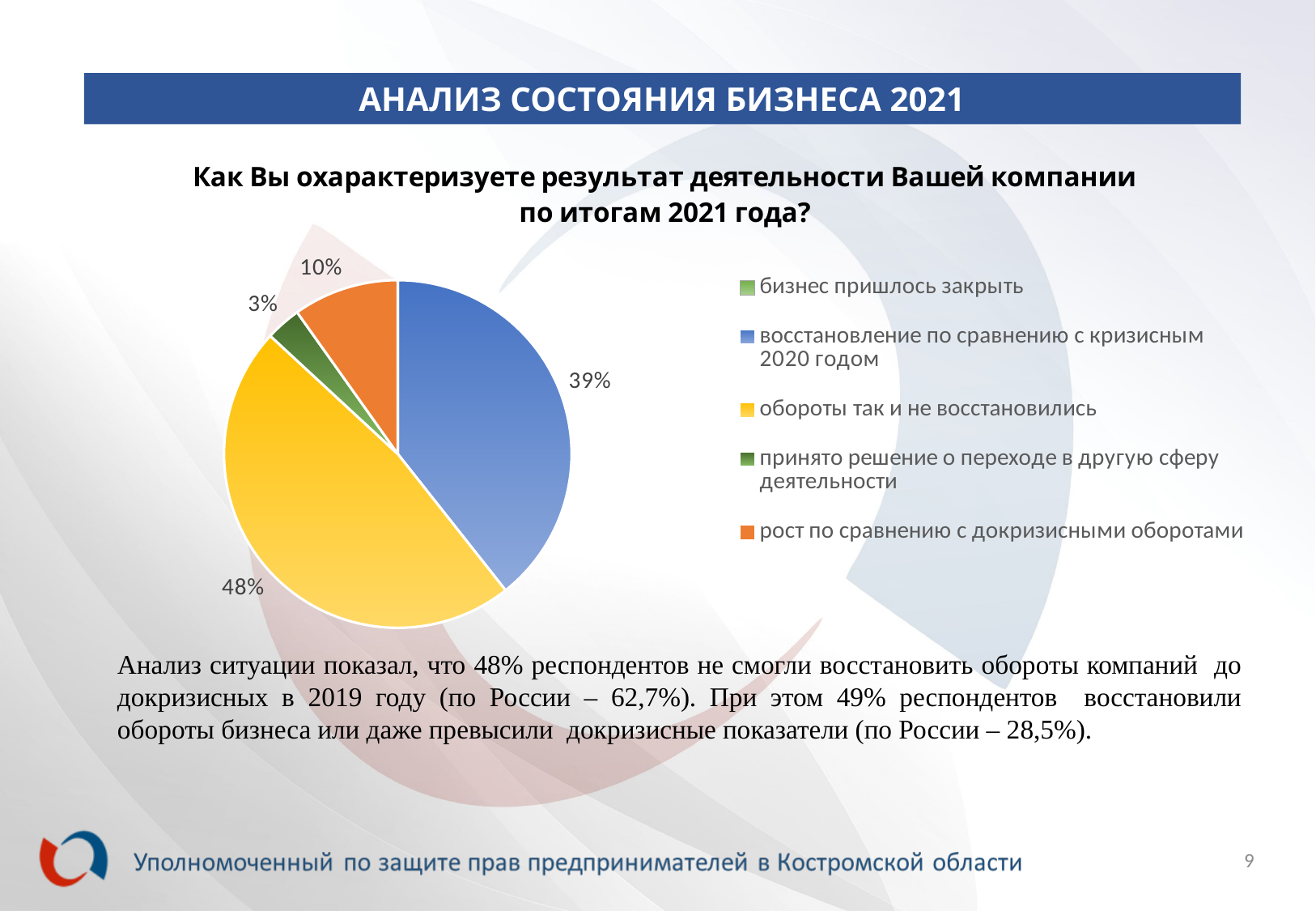
What share of respondents answered "рост по сравнению с докризисными оборотами"? 10% Which is larger: the share for "обороты так и не восстановились" or the share for "восстановление по сравнению с кризисным 2020 годом"? обороты так и не восстановились How many answer options are listed in the chart legend? 5 What is the difference between the share for "обороты так и не восстановились" and the share for "восстановление по сравнению с кризисным 2020 годом"? 9 percentage points What colour is the slice for "обороты так и не восстановились"? yellow What kind of chart is shown on the slide? pie chart What share of respondents answered "обороты так и не восстановились"? 48% What question is the pie chart titled with? Как Вы охарактеризуете результат деятельности Вашей компании по итогам 2021 года? Which is larger: the share for "восстановление по сравнению с кризисным 2020 годом" or the share for "рост по сравнению с докризисными оборотами"? восстановление по сравнению с кризисным 2020 годом What share of respondents answered "восстановление по сравнению с кризисным 2020 годом"? 39% Which answer option has the largest share of the pie? обороты так и не восстановились